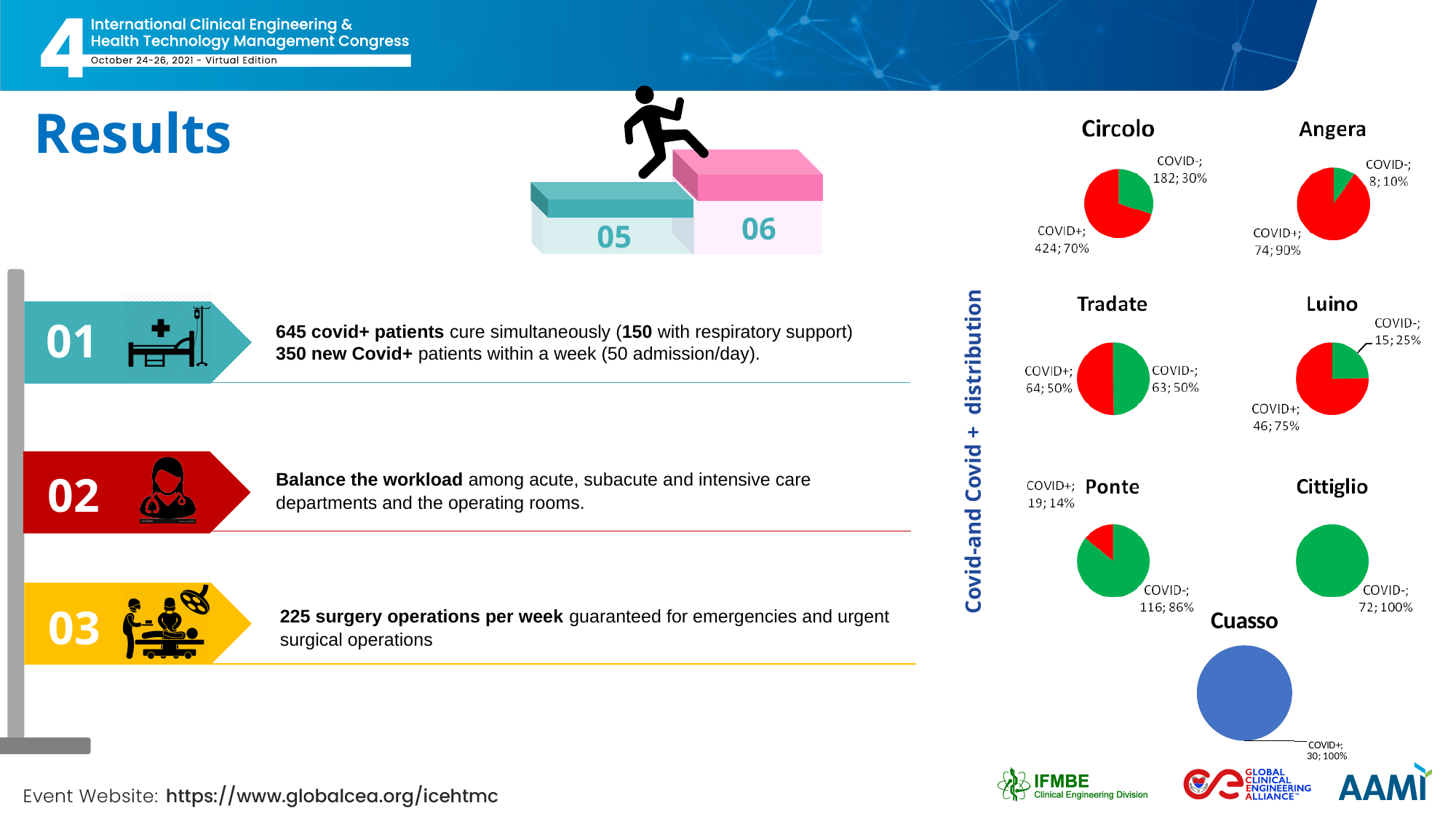
In the Luino pie chart, what is the difference between the COVID+ and COVID- counts? 31 In the Circolo pie chart, how many COVID+ patients are shown? 424 In the Cittiglio pie chart, how many COVID- patients are shown? 72 In the Cuasso pie chart, what percentage is COVID+? 100% In the Angera pie chart, what percentage is COVID+? 90% In the Tradate pie chart, how many COVID- patients are shown? 63 What type of chart is used to show the Covid-and Covid+ distribution for each site? Pie chart In the Angera pie chart, what is the total number of patients across both slices? 82 In the Ponte pie chart, which slice is larger, COVID+ or COVID-? COVID- How many pie charts are shown on the slide? 7 In the Ponte pie chart, what share of the pie is COVID+? 14%